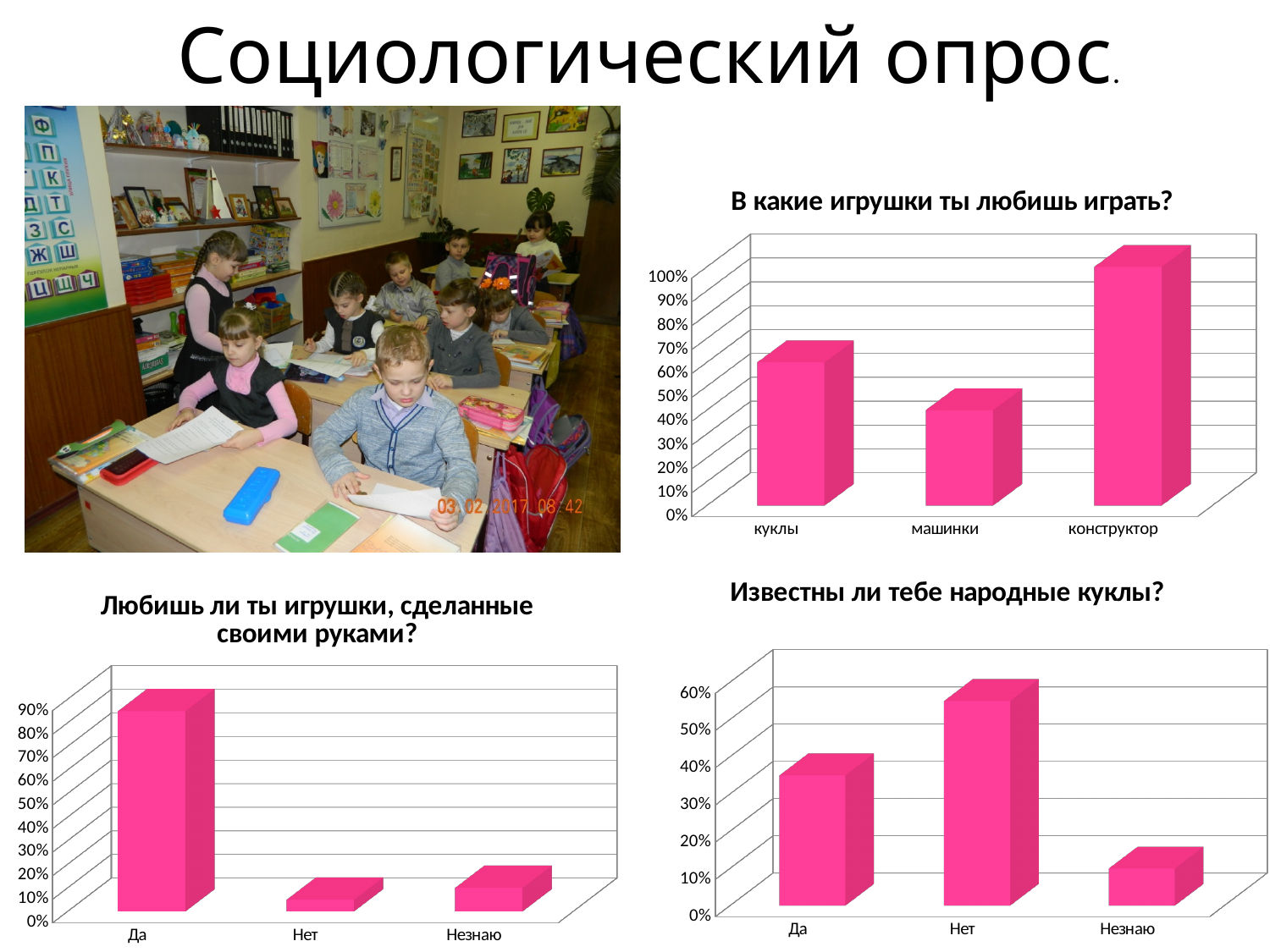
What kind of chart is the one titled "Известны ли тебе народные куклы?"? bar chart In the chart titled "В какие игрушки ты любишь играть?", how many categories are shown? 3 In the chart titled "В какие игрушки ты любишь играть?", which category has the highest value? конструктор In the chart titled "В какие игрушки ты любишь играть?", which category has the lowest value? машинки In the chart titled "Любишь ли ты игрушки, сделанные своими руками?", which category has the highest value? Да In the chart titled "В какие игрушки ты любишь играть?", is the value for машинки greater or less than 50%? less In the chart titled "В какие игрушки ты любишь играть?", is the value for конструктор greater or less than 80%? greater In the chart titled "Известны ли тебе народные куклы?", which category has the highest value? Нет In the chart titled "Любишь ли ты игрушки, сделанные своими руками?", is the value for Да greater or less than 70%? greater In the chart titled "Известны ли тебе народные куклы?", which is larger, the value for Да or the value for Незнаю? Да In the chart titled "Любишь ли ты игрушки, сделанные своими руками?", which category has the lowest value? Нет